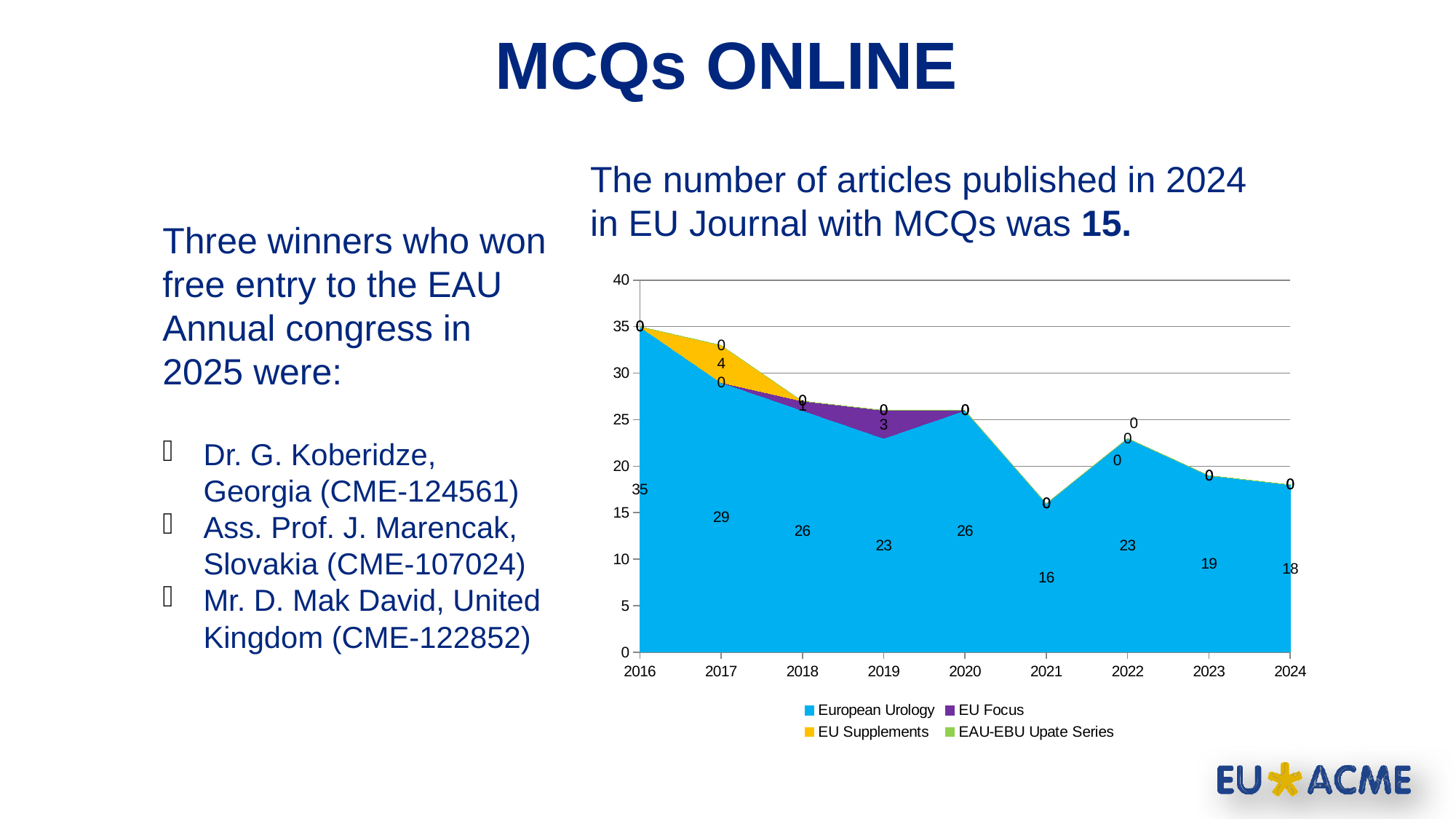
What is the value for EU Focus in 2019? 3 What is the value for EU Supplements in 2017? 4 What is the difference between the European Urology values for 2016 and 2024? 17 What is the value for European Urology in 2024? 18 What is the value for European Urology in 2021? 16 How many series does the chart legend list? 4 How many years are shown on the x axis of the chart? 9 What kind of chart is shown on the slide? area chart In which year is the European Urology value highest? 2016 Which is larger, the European Urology value for 2022 or for 2023? 2022 In which year is the European Urology value lowest? 2021 What is the value for European Urology in 2016? 35